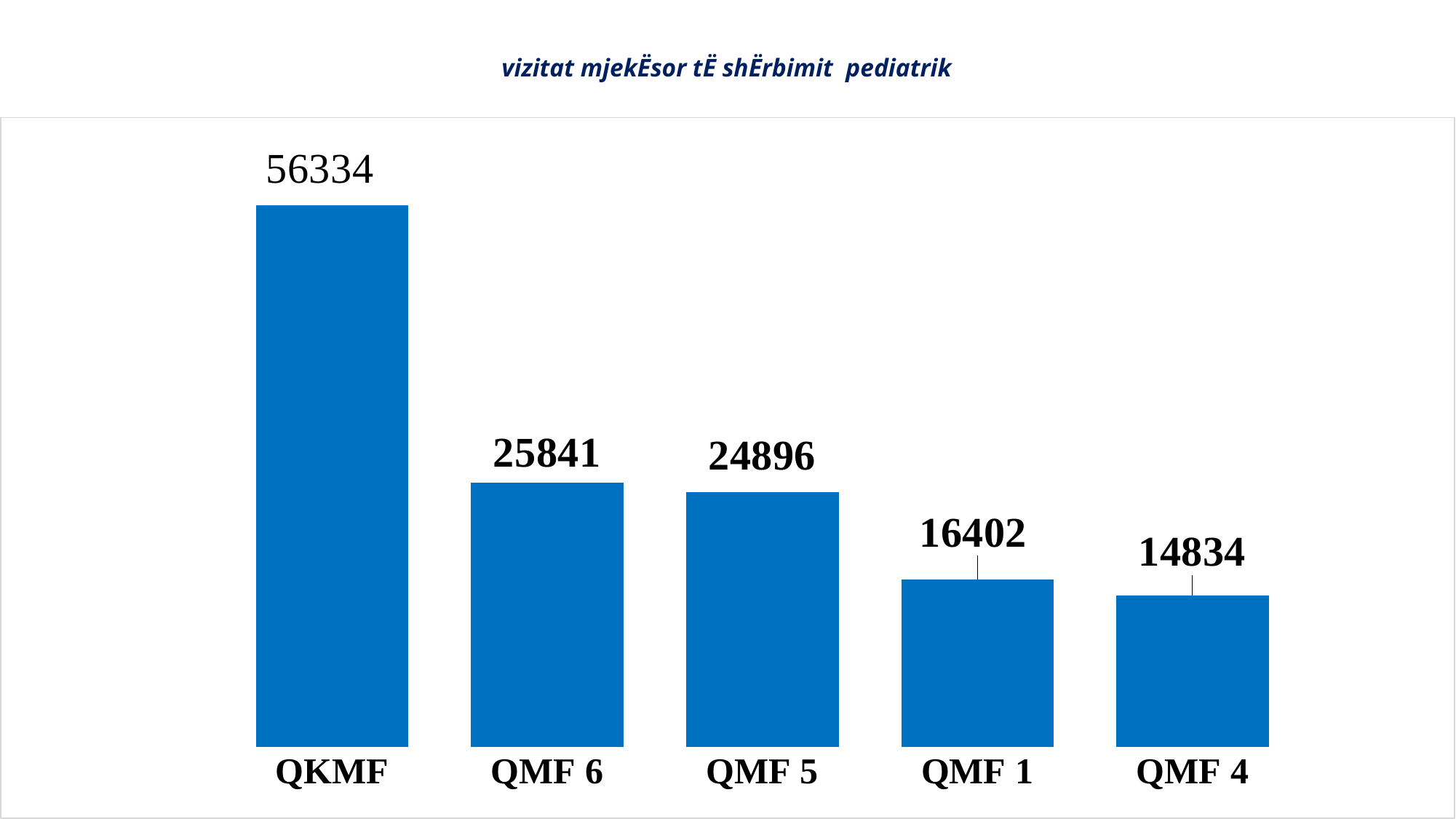
How many categories are shown in the chart? 5 What is the value for QMF 4? 14834 Which category has the highest value? QKMF Which category has the lowest value? QMF 4 What is the difference between the values for QMF 1 and QMF 4? 1568 What is the value for QMF 5? 24896 What is the difference between the values for QKMF and QMF 6? 30493 What is the value for QMF 6? 25841 Which is larger, the value for QMF 6 or the value for QMF 5? QMF 6 What is the value for QKMF? 56334 What kind of chart is shown on the slide? Bar chart What is the value for QMF 1? 16402